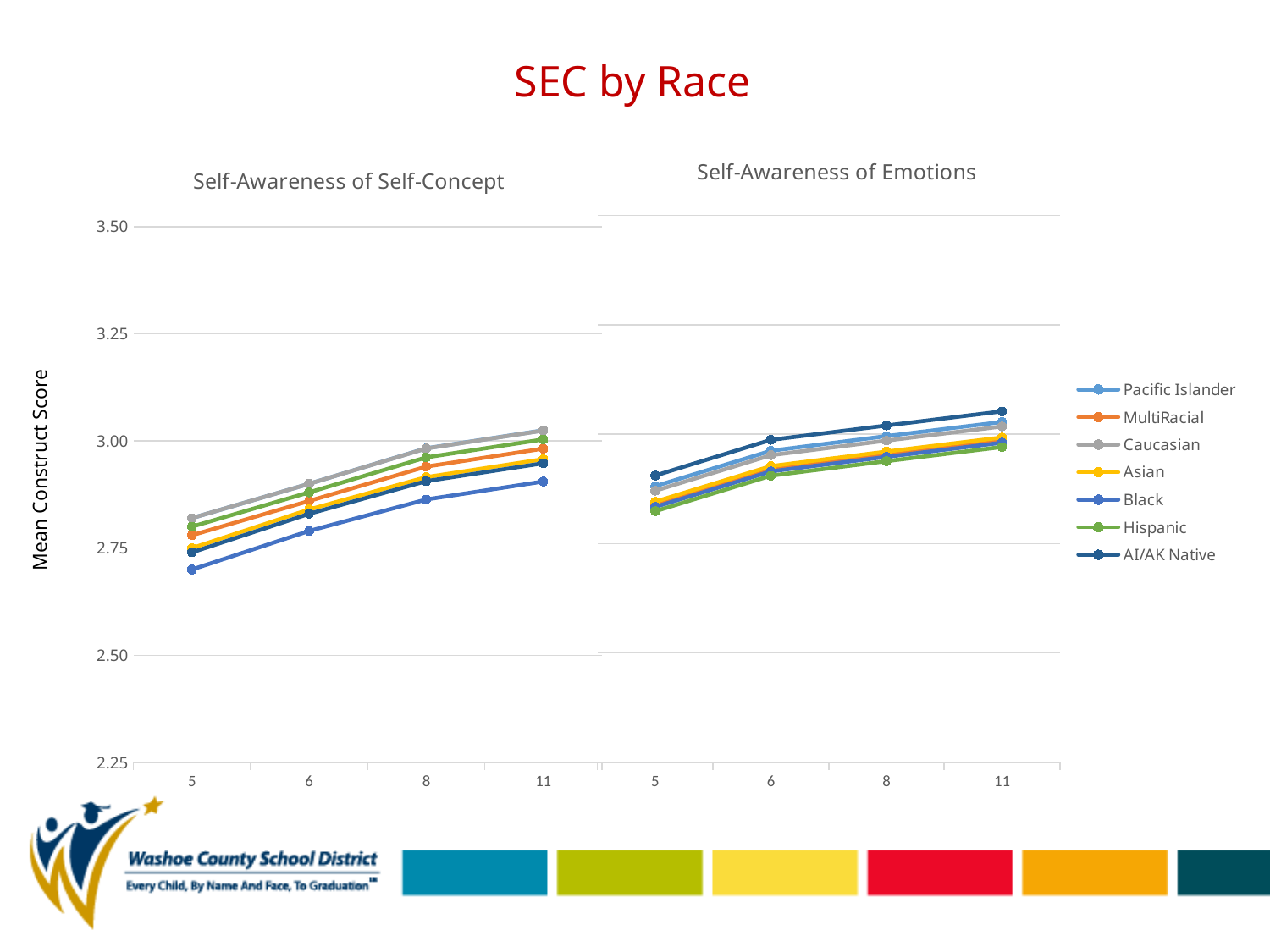
In the Self-Awareness of Self-Concept chart, is the value for Black at grade 5 greater or less than 2.75? less What kind of chart is the Self-Awareness of Self-Concept chart? line chart In the Self-Awareness of Self-Concept chart, which race group has the lowest values across the grades? Black How many grade levels are shown on the x axis of the Self-Awareness of Emotions chart? 4 In the Self-Awareness of Emotions chart, is the value for AI/AK Native at grade 5 greater or less than 3.00? less In the Self-Awareness of Emotions chart, is the value for Hispanic at grade 5 greater or less than 2.75? greater What is the label on the shared y axis of the charts? Mean Construct Score How many series does the legend list? 7 In the Self-Awareness of Emotions chart, which race group has the highest value at grade 11? AI/AK Native In the Self-Awareness of Self-Concept chart, do the values for Caucasian rise or fall from grade 5 to grade 11? rise